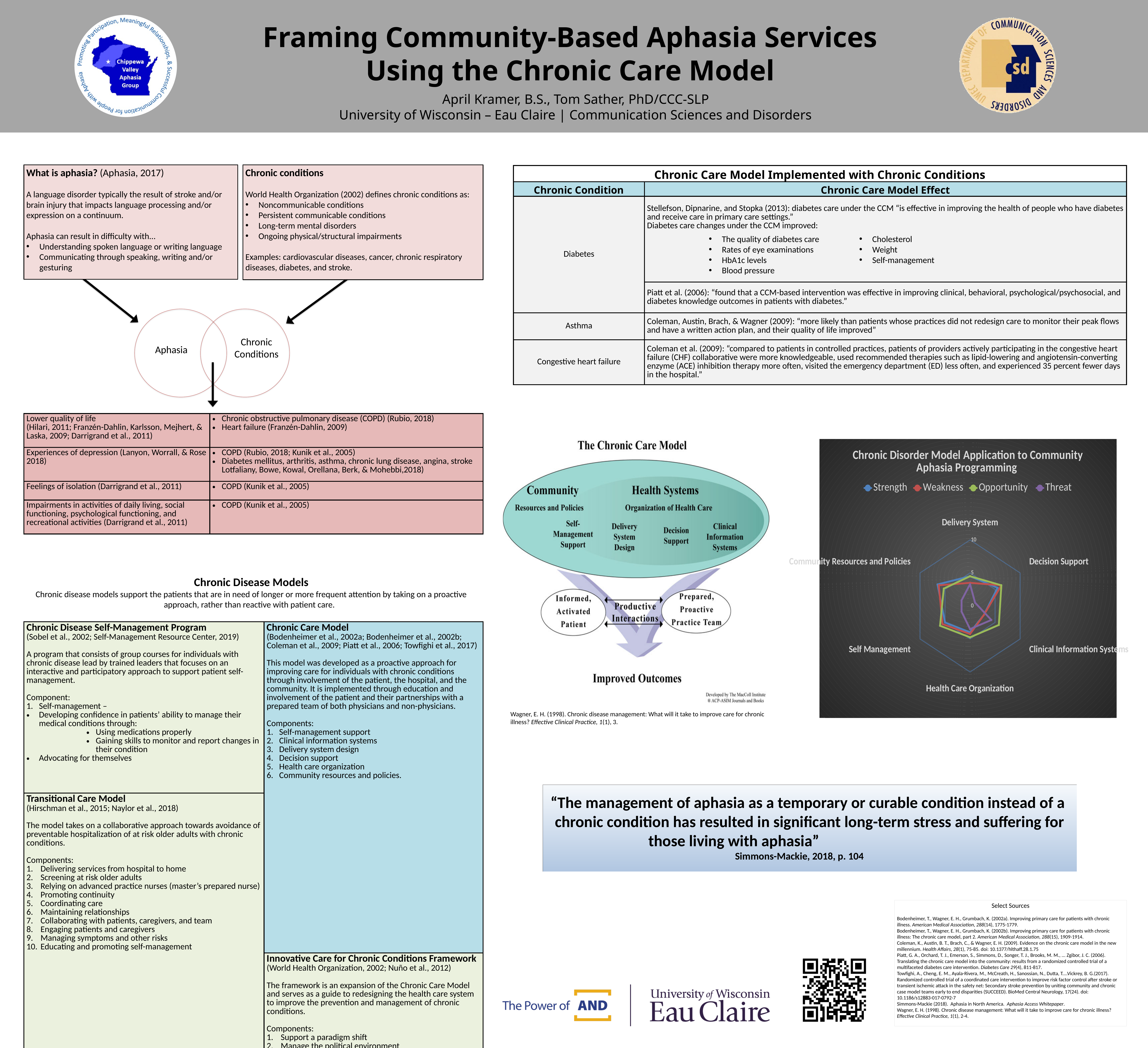
How many series does the legend of the 'Chronic Disorder Model Application to Community Aphasia Programming' chart list? 4 In the 'Chronic Disorder Model Application to Community Aphasia Programming' chart, is the value for Strength on the Delivery System axis greater or less than 10? less In the 'Chronic Disorder Model Application to Community Aphasia Programming' chart, is the value for Weakness on the Health Care Organization axis greater or less than 10? less In the 'Chronic Disorder Model Application to Community Aphasia Programming' chart, is the value for Opportunity on the Self Management axis greater or less than 10? less How many categories (axes) are plotted on the 'Chronic Disorder Model Application to Community Aphasia Programming' radar chart? 6 What kind of chart is the 'Chronic Disorder Model Application to Community Aphasia Programming' chart? radar chart Which series in the radar chart legend is shown in purple? Threat What is the maximum value shown on the axis scale of the 'Chronic Disorder Model Application to Community Aphasia Programming' radar chart? 10 What is the title of the radar chart on the slide? Chronic Disorder Model Application to Community Aphasia Programming